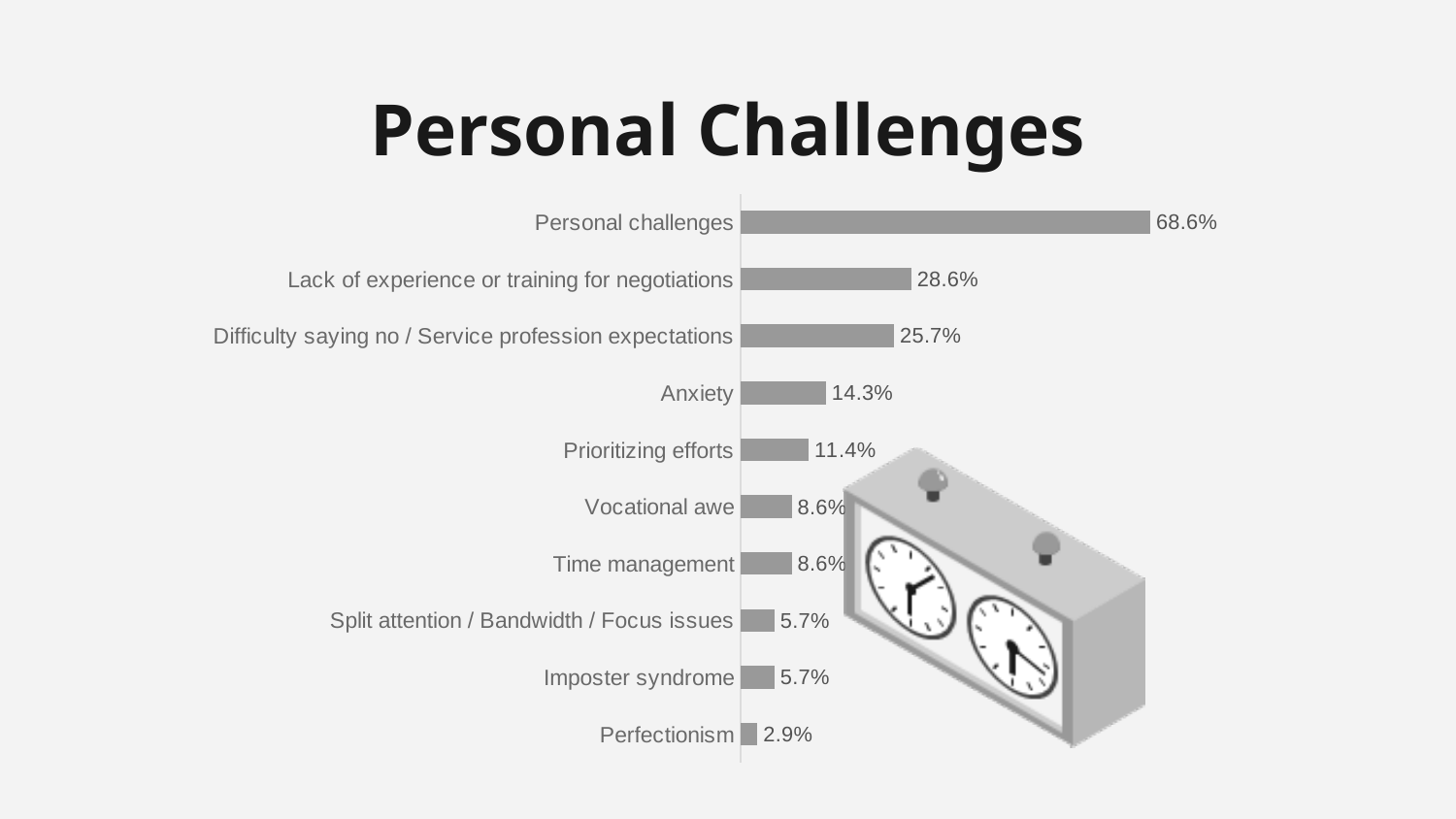
Which category has the lowest value? Perfectionism What is the title of the slide? Personal Challenges What is the value for Lack of experience or training for negotiations? 28.6% Which is larger, Lack of experience or training for negotiations or Difficulty saying no / Service profession expectations? Lack of experience or training for negotiations What is the difference between Personal challenges and Lack of experience or training for negotiations? 40.0% Which category has the highest value? Personal challenges What is the value for Anxiety? 14.3% What is the difference between Difficulty saying no / Service profession expectations and Anxiety? 11.4% How many categories are shown in the chart? 10 What is the value for Prioritizing efforts? 11.4% What kind of chart is shown on the slide? Bar chart What is the value for Imposter syndrome? 5.7%